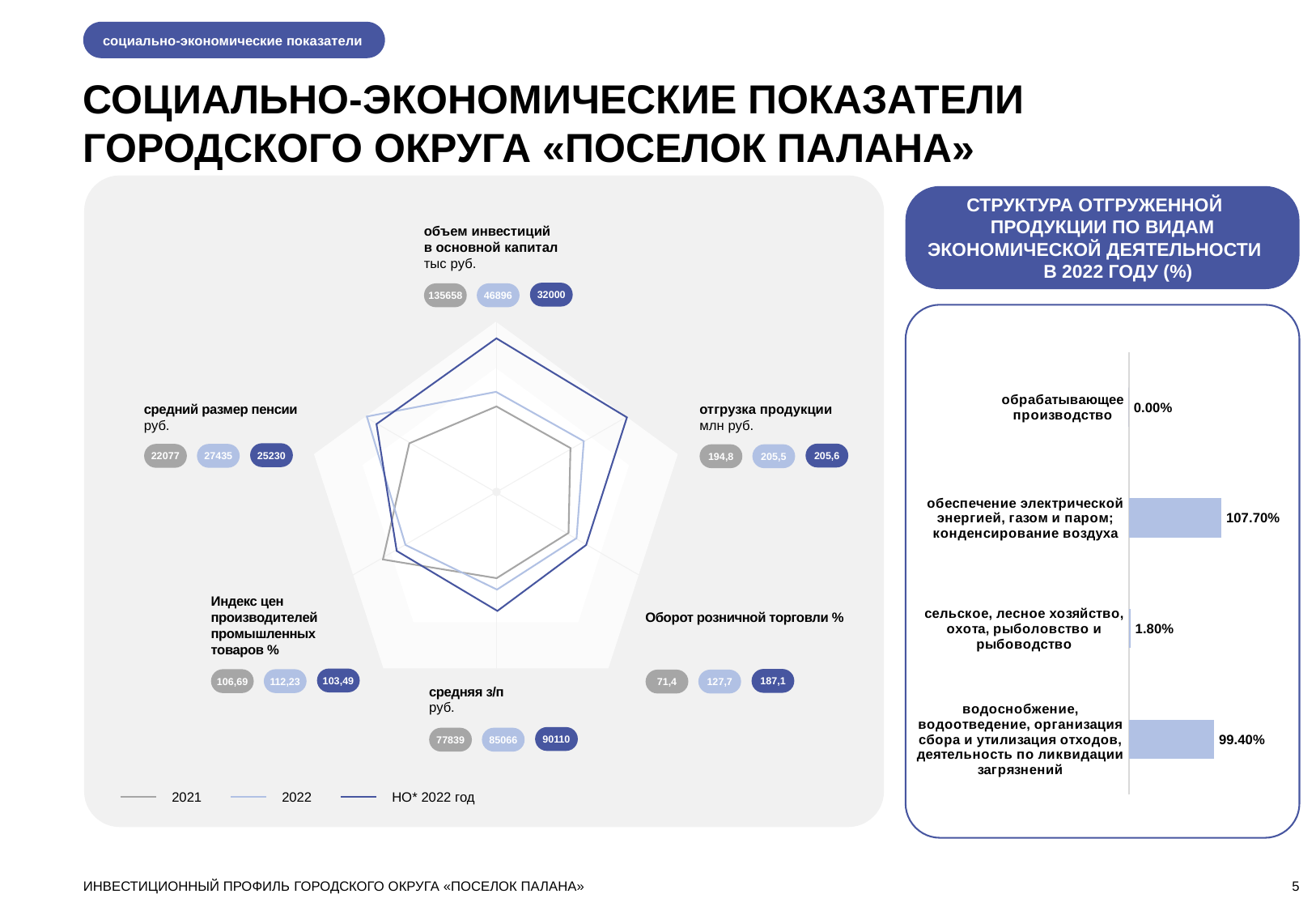
On the bar chart on the right, how many categories are shown? 4 On the radar chart on the left, what is the difference between the 2022 and 2021 values for «средняя з/п»? 7227 On the bar chart on the right, which category has the lowest value? обрабатывающее производство On the bar chart on the right, what is the value for «водоснобжение, водоотведение, организация сбора и утилизация отходов, деятельность по ликвидации загрязнений»? 99.40% What kind of chart is shown on the right side of the slide? bar chart On the bar chart titled «Структура отгруженной продукции по видам экономической деятельности в 2022 году (%)», what is the value for «обеспечение электрической энергией, газом и паром; конденсирование воздуха»? 107.70% On the bar chart on the right, what is the difference between the value for «обеспечение электрической энергией, газом и паром; конденсирование воздуха» and the value for «водоснобжение, водоотведение...»? 8.30% On the radar chart on the left, what is the 2021 value for «объем инвестиций в основной капитал»? 135658 On the bar chart on the right, which category has the highest value? обеспечение электрической энергией, газом и паром; конденсирование воздуха On the radar chart on the left, which is larger for «средний размер пенсии»: the 2022 value or the «НО* 2022 год» value? 2022 On the radar chart on the left, how many series does the legend list? 3 On the radar chart on the left, what is the «НО* 2022 год» value for «Оборот розничной торговли %»? 187,1